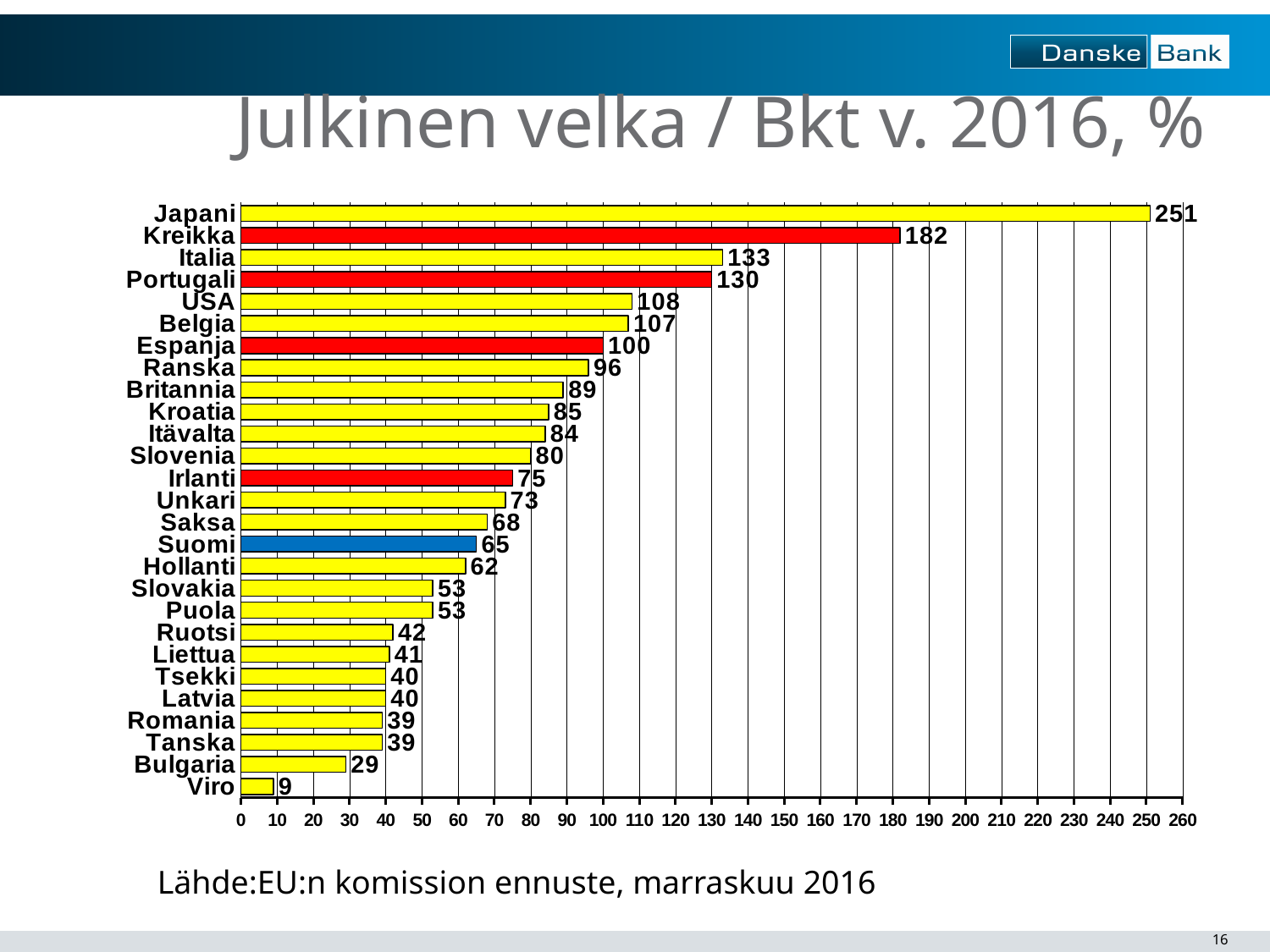
Which has a larger value, Italia or Portugali? Italia What kind of chart is shown on the slide? Bar chart Which country's bar is coloured blue? Suomi What is the value for Viro? 9 What is the difference between the values for Japani and Kreikka? 69 How many countries are shown in the chart? 27 Which country has the highest value? Japani What is the value for Kreikka? 182 What is the title of the chart? Julkinen velka / Bkt v. 2016, % Is the value for Espanja greater or less than 90? greater Which country has the lowest value? Viro What is the value for Suomi? 65